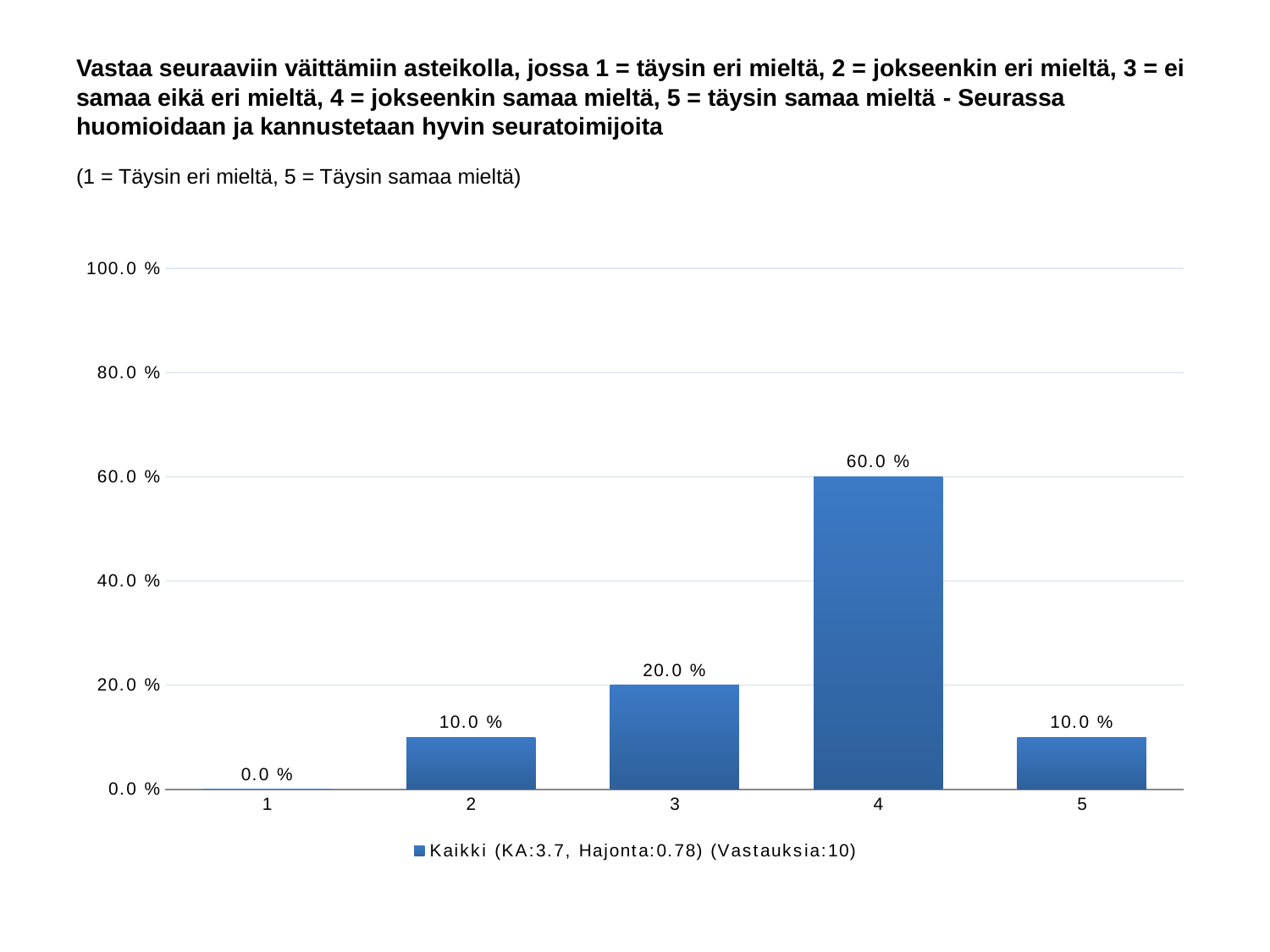
Which is larger, the value for category 3 or the value for category 5? 3 What is the value for category 4? 60.0 % What is the value for category 3? 20.0 % What kind of chart is shown? bar chart What is the value for category 1? 0.0 % How many categories are shown on the x axis? 5 How many series does the legend list? 1 Which category has the highest value? 4 Is the value for category 4 greater or less than 40.0 %? greater What is the difference between the values for category 4 and category 3? 40.0 % Which category has the lowest value? 1 What is the legend entry for the series? Kaikki (KA:3.7, Hajonta:0.78) (Vastauksia:10)